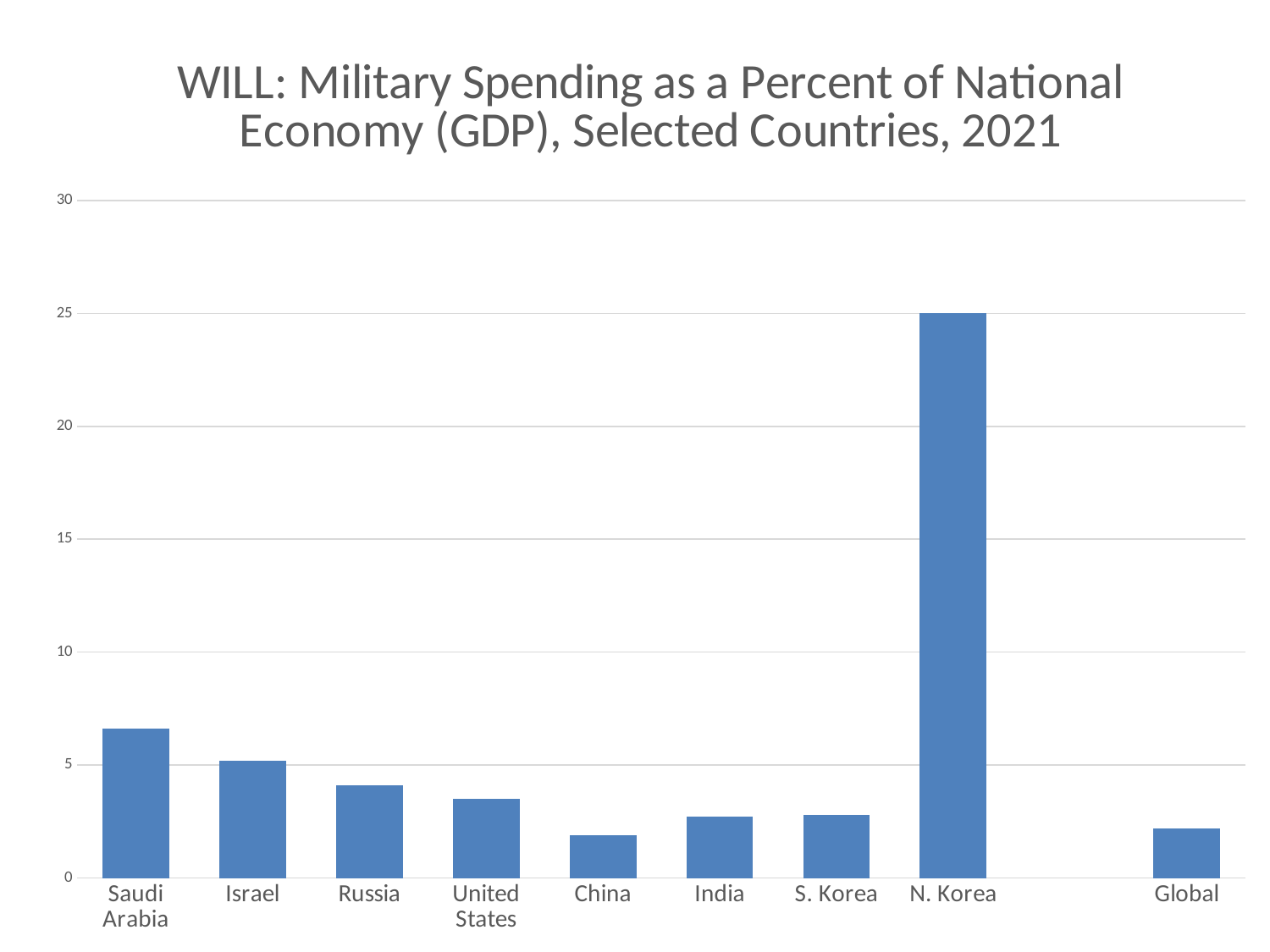
Is the value for Global greater or less than 5? less Which is larger, the value for Saudi Arabia or the value for Israel? Saudi Arabia What kind of chart is shown on the slide? bar chart How many labeled categories are shown on the x axis? 9 Is the value for N. Korea greater or less than 20? greater Is the value for China greater or less than 5? less What year does the chart title say the data is for? 2021 Which country has the highest military spending as a percent of GDP? N. Korea Which is larger, the value for Russia or the value for China? Russia What value does the N. Korea bar reach on the axis? 25